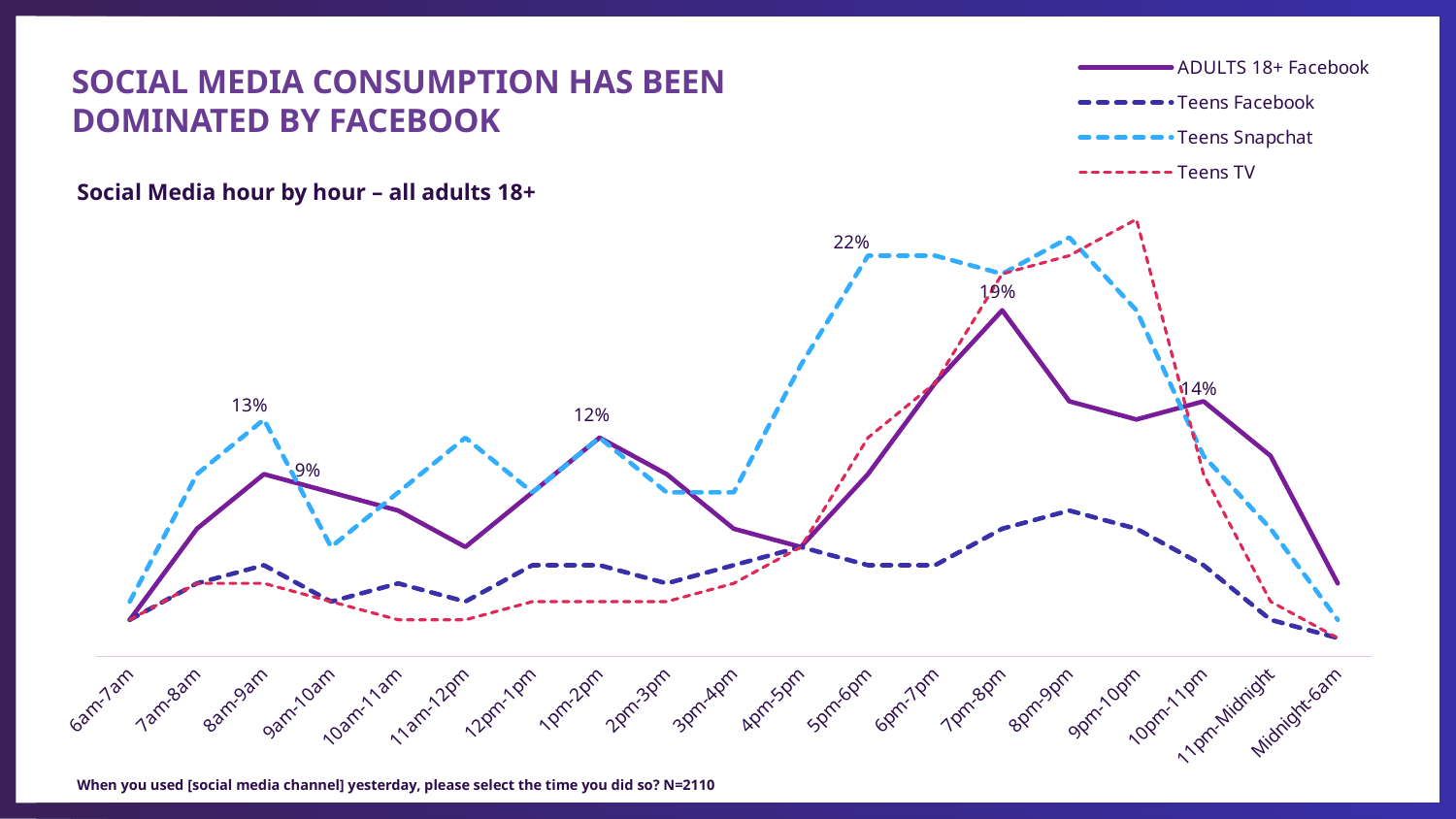
How many series does the legend list? 4 Does the Teens TV line rise or fall from 9pm-10pm to Midnight-6am? fall What is the value for Teens Snapchat at 5pm-6pm? 22% In which time slot does Teens TV reach its highest value? 9pm-10pm What is the value for ADULTS 18+ Facebook at 10pm-11pm? 14% What is the value for ADULTS 18+ Facebook at 7pm-8pm? 19% How many time-slot categories are shown on the x axis? 19 In which time slot does ADULTS 18+ Facebook reach its highest value? 7pm-8pm What is the value for Teens Snapchat at 8am-9am? 13% What is the difference between the ADULTS 18+ Facebook values at 7pm-8pm (19%) and 10pm-11pm (14%)? 5% At 5pm-6pm, which is larger: Teens Snapchat or ADULTS 18+ Facebook? Teens Snapchat What type of chart is shown on the slide? line chart